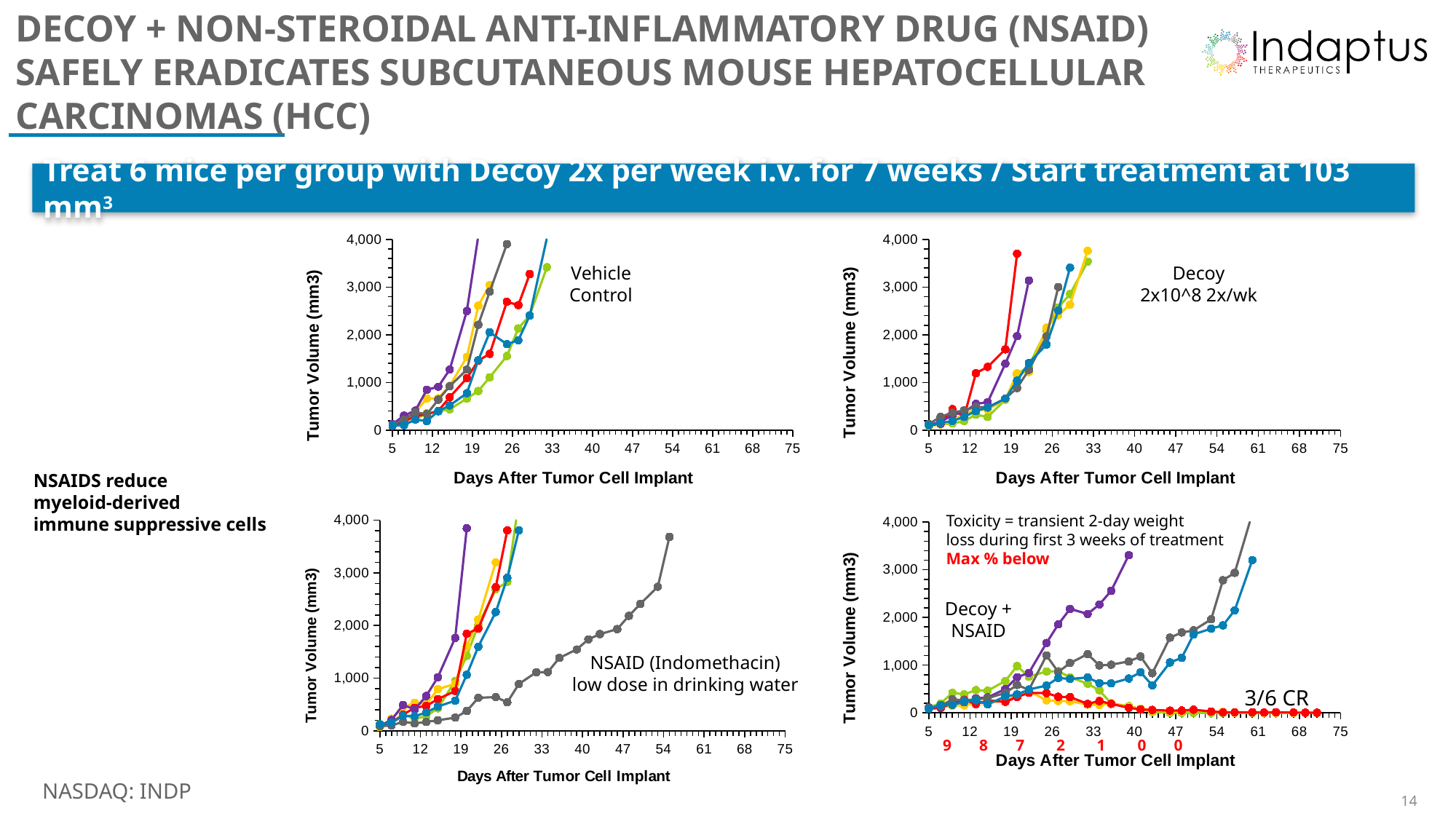
What is the first red maximum weight-loss percentage printed below the x axis of the Decoy + NSAID chart? 9 What is the x-axis title of the Vehicle Control chart? Days After Tumor Cell Implant In the Decoy + NSAID chart, is the red line's value at day 61 greater or less than 1,000? less What is the highest tick value on the y axis of the Decoy 2x10^8 2x/wk chart? 4,000 In the Vehicle Control chart, does tumor volume rise or fall as days after tumor cell implant increase? Rise What complete response fraction is printed on the Decoy + NSAID chart? 3/6 CR What is the last tick value on the x axis of the NSAID (Indomethacin) chart at the bottom left? 75 How many charts are shown on the slide? 4 What is the y-axis title of the Decoy + NSAID chart at the bottom right? Tumor Volume (mm3) In the Decoy + NSAID chart, is the purple line's value at day 40 greater or less than 3,000? greater What kind of chart is the Vehicle Control chart at the top left? Line chart